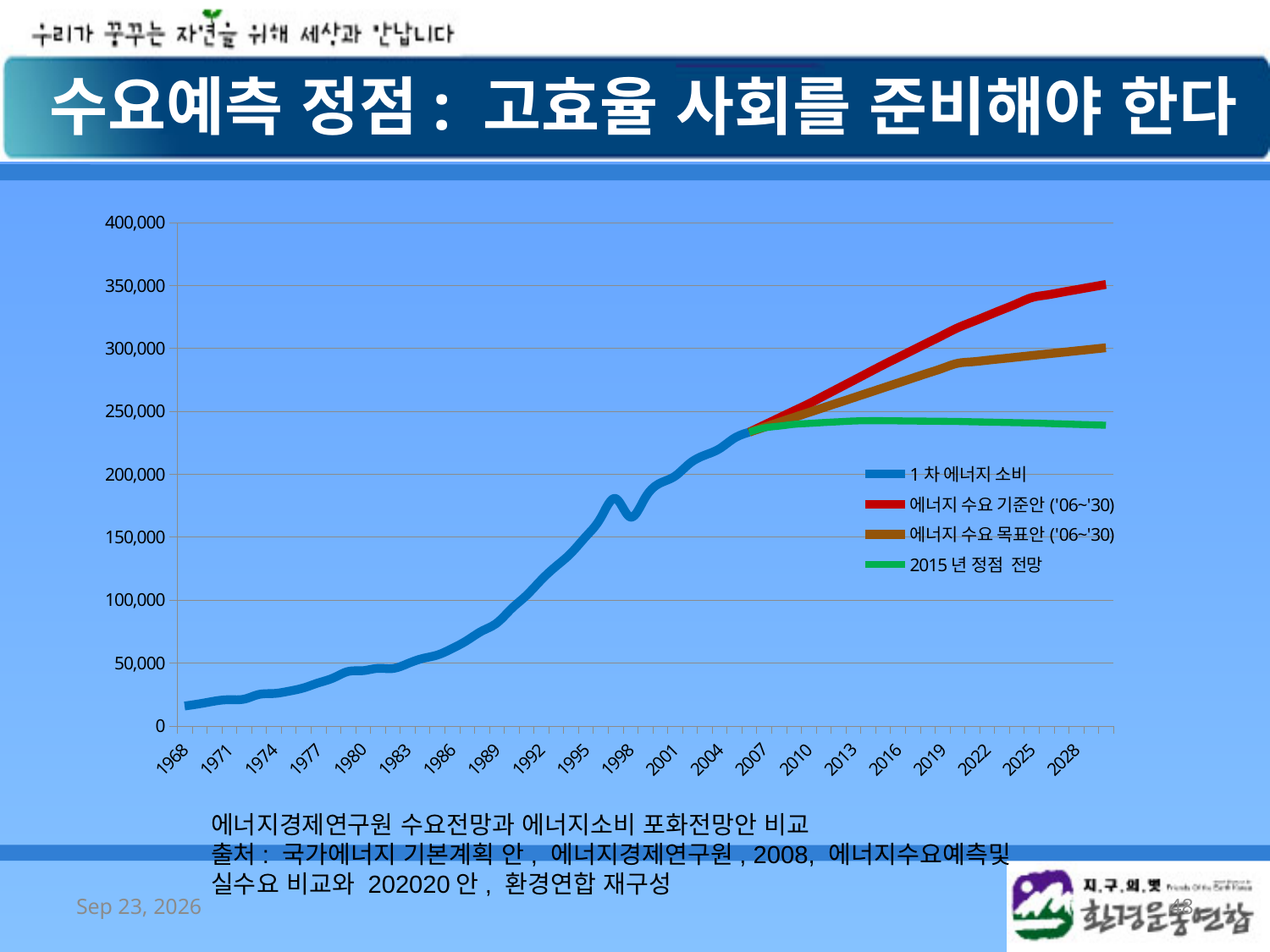
Is the value of 2015년 정점 전망 in 2028 greater or less than 250,000? less Is the value of 1차 에너지 소비 in 1968 greater or less than 50,000? less Which series is drawn in green in the chart? 2015년 정점 전망 How many series does the chart's legend list? 4 In 2025, which is higher: 에너지 수요 목표안 ('06~'30) or 2015년 정점 전망? 에너지 수요 목표안 ('06~'30) Which series reaches the highest value at the right end of the chart (2028)? 에너지 수요 기준안 ('06~'30) Which series has the lowest value at the right end of the chart (2028)? 2015년 정점 전망 Does the 1차 에너지 소비 line generally rise or fall from 1968 to 2007? rise What kind of chart is shown on the slide? line chart Is the value of 1차 에너지 소비 in 2004 greater or less than 200,000? greater Which series is drawn in red in the chart? 에너지 수요 기준안 ('06~'30)